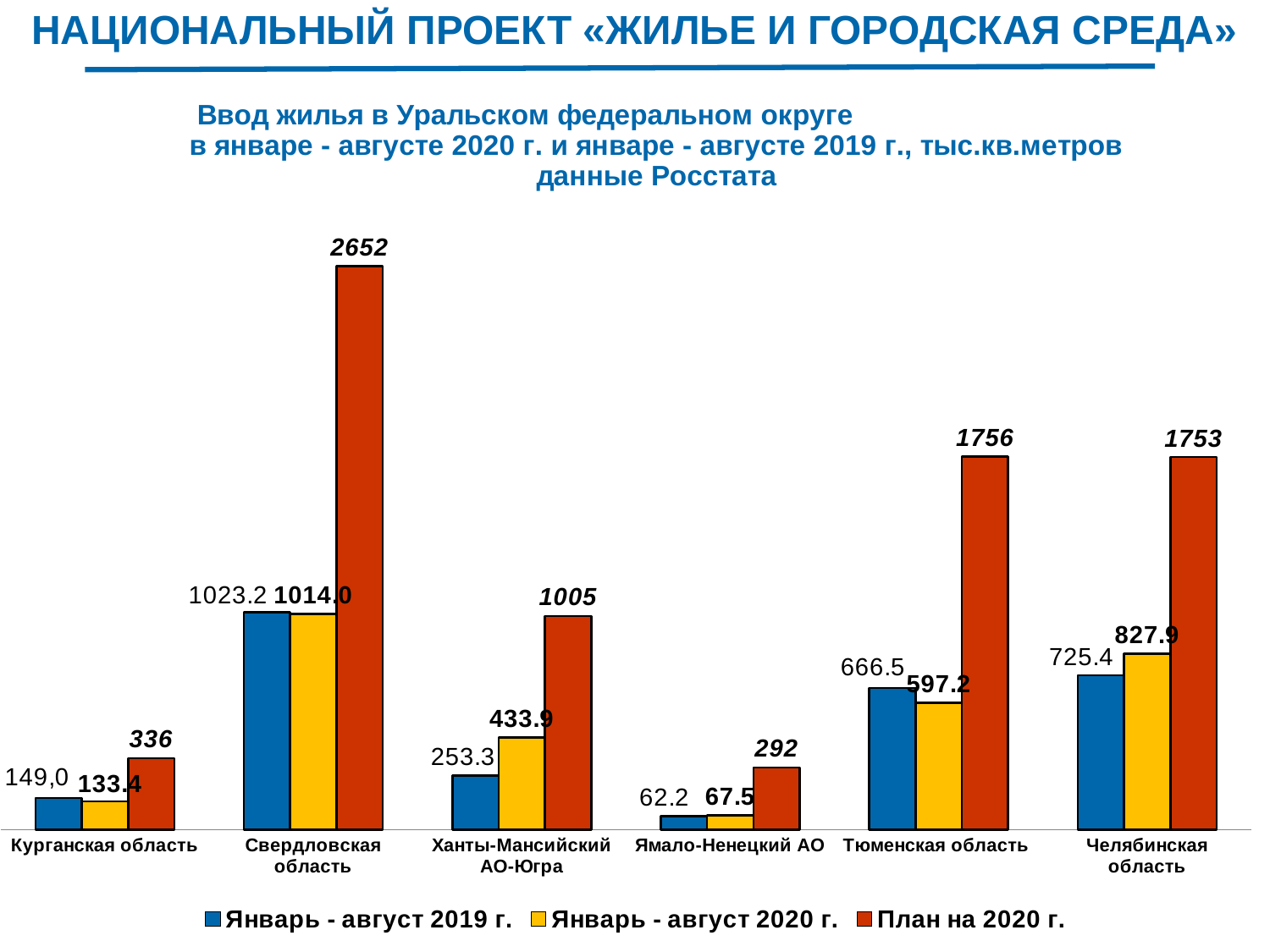
What kind of chart is shown on the slide? Bar chart How many series does the legend list? 3 For Ханты-Мансийский АО-Югра, what is the difference between «Январь - август 2020 г.» and «Январь - август 2019 г.»? 180.6 What is the value of «План на 2020 г.» for Свердловская область? 2652 For Челябинская область, how much larger is «План на 2020 г.» than «Январь - август 2020 г.»? 925.1 How many regions are shown on the x axis of the chart? 6 What is the value of «Январь - август 2019 г.» for Ямало-Ненецкий АО? 62.2 What is the value of «Январь - август 2020 г.» for Челябинская область? 827.9 Which region has the lowest value for «Январь - август 2020 г.»? Ямало-Ненецкий АО Which region has the highest value for «План на 2020 г.»? Свердловская область For Тюменская область, which is larger: «Январь - август 2019 г.» or «Январь - август 2020 г.»? Январь - август 2019 г. What is the value of «Январь - август 2019 г.» for Тюменская область? 666.5